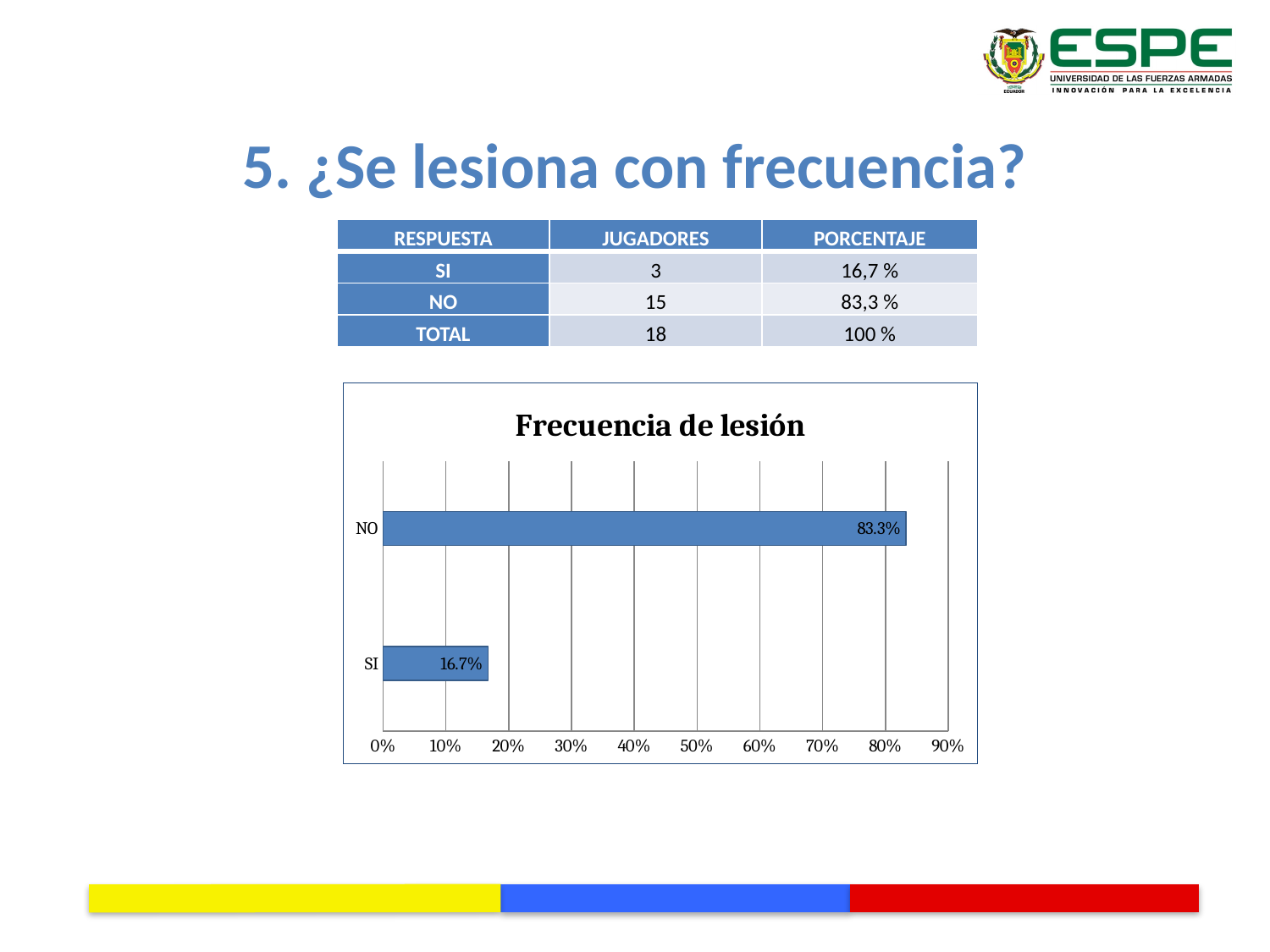
Is the value for NO greater or less than 80%? greater What is the highest value shown on the x axis of the chart? 90% What is the difference between the values for NO and SI? 66.6% Which is larger, the value for NO or the value for SI? NO What is the value for SI in the chart? 16.7% What is the value for NO in the chart? 83.3% Is the value for SI greater or less than 20%? less How many categories are shown in the chart? 2 What kind of chart is shown on the slide? bar chart Which category has the highest value in the chart? NO Which category has the lowest value in the chart? SI What is the title of the chart? Frecuencia de lesión